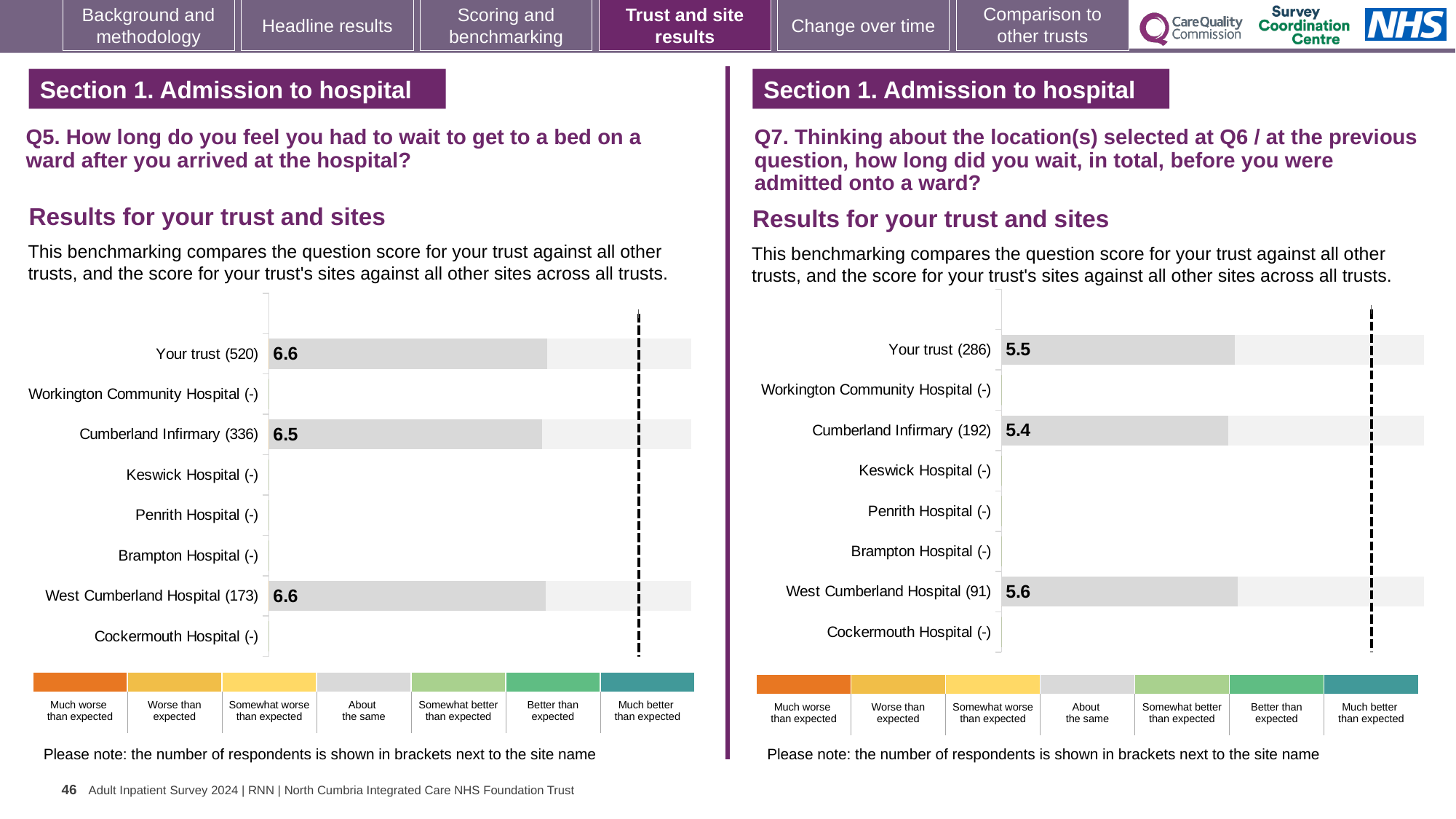
In the Q5 chart on the left, what is the score for Your trust (520)? 6.6 In the Q7 chart on the right, what is the difference between the scores for West Cumberland Hospital (91) and Cumberland Infirmary (192)? 0.2 In the Q7 chart on the right, what is the score for Your trust (286)? 5.5 What kind of chart is used in the Q7 chart on the right? Bar chart In the Q7 chart on the right, which site has the lowest score? Cumberland Infirmary (192) How many site categories are listed in the Q5 chart on the left? 8 In the Q5 chart on the left, what is the difference between the scores for Your trust (520) and Cumberland Infirmary (336)? 0.1 In the Q5 chart on the left, what is the score for West Cumberland Hospital (173)? 6.6 In the Q7 chart on the right, which site has the highest score? West Cumberland Hospital (91) In the Q7 chart on the right, what is the score for West Cumberland Hospital (91)? 5.6 In the Q5 chart on the left, what is the score for Cumberland Infirmary (336)? 6.5 In the Q7 chart on the right, which is larger: the score for Your trust (286) or for Cumberland Infirmary (192)? Your trust (286)